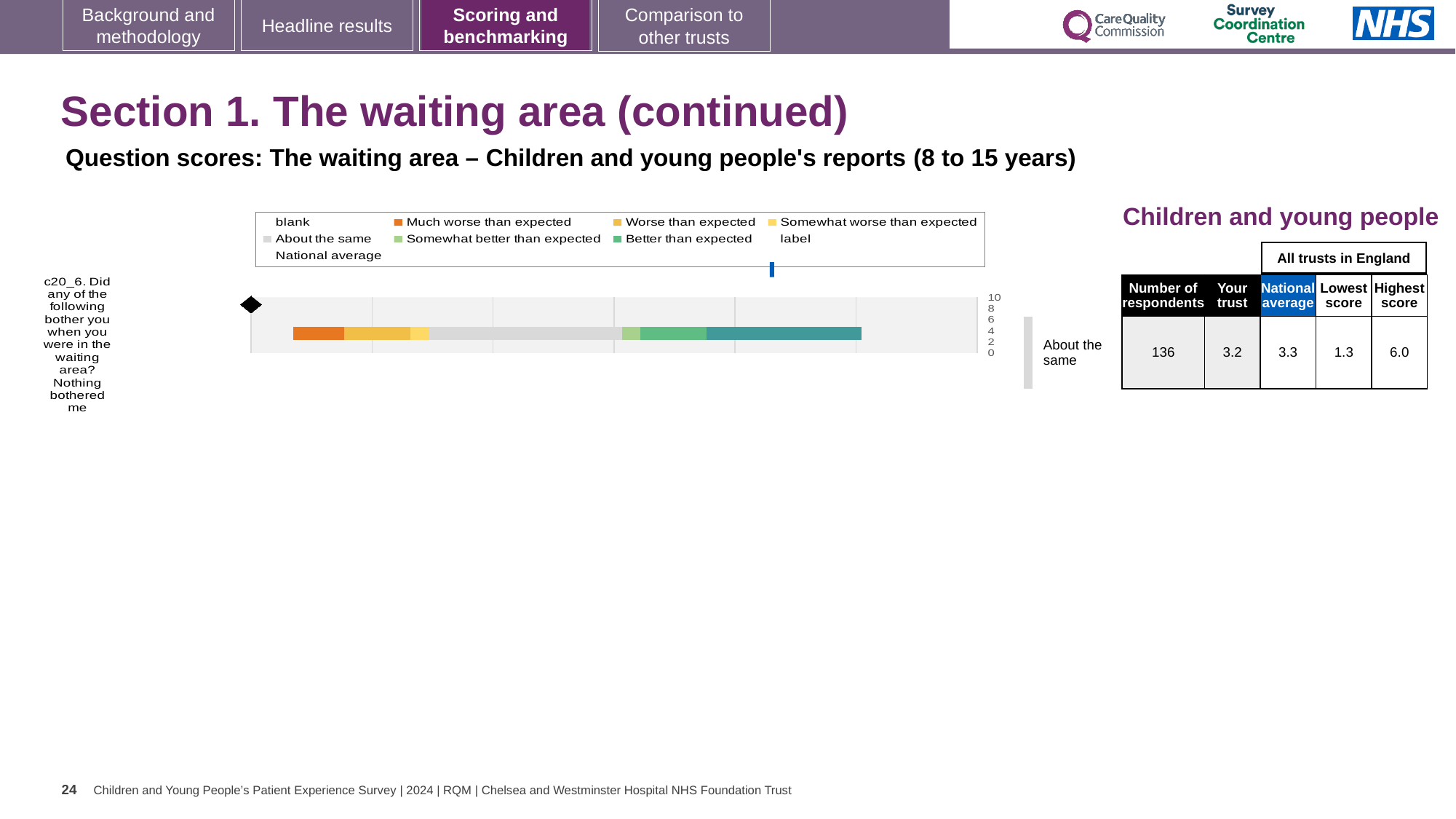
In the table, what is the score for Your trust? 3.2 How many questions (categories) are plotted in the bar chart? 1 How many entries does the chart legend list? 9 In the table, what is the National average score? 3.3 In the table, what is the Highest score among all trusts in England? 6.0 Which legend entry is shown in orange? Much worse than expected What is the question code of the item plotted in the chart? c20_6 In the table, what is the difference between the Highest score and the Lowest score? 4.7 In the table, what is the number of respondents for the Children and young people question? 136 In the table, which is larger: Your trust score or the National average? National average What kind of chart is shown on the slide? Bar chart What benchmark category is shown next to the bar for question c20_6? About the same